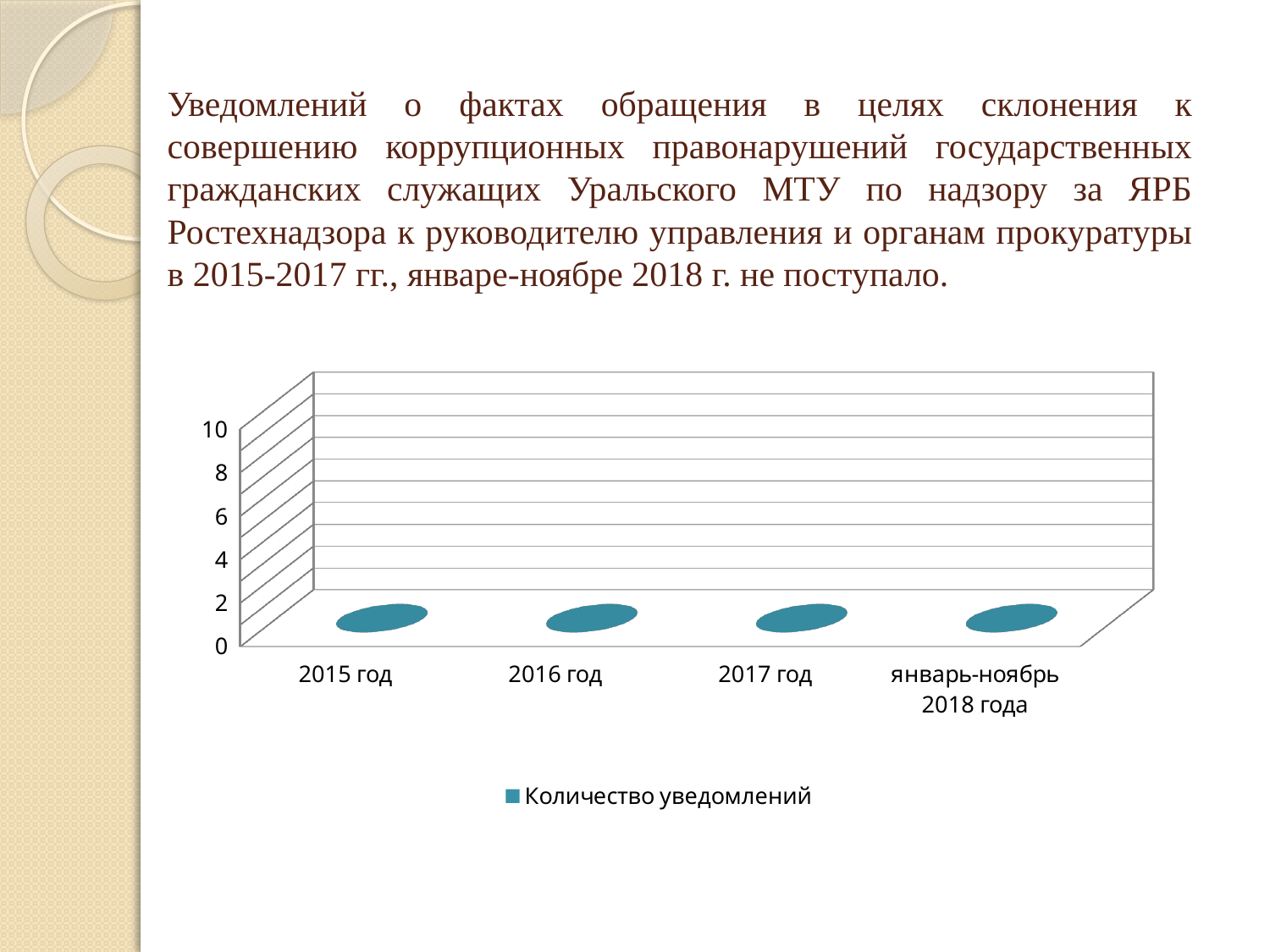
Is the value for 2017 год greater or less than 2? less What is the name of the series in the chart's legend? Количество уведомлений What is the value for январь-ноябрь 2018 года in the chart? 0 What kind of chart is shown on the slide? bar chart Do the values rise, fall, or stay the same from 2015 год to январь-ноябрь 2018 года? stay the same What is the highest value shown on the chart's vertical axis? 10 Is the value for январь-ноябрь 2018 года greater or less than 4? less What is the value for 2016 год in the chart? 0 How many categories are shown on the x axis of the chart? 4 What is the value for 2015 год in the chart? 0 How many series does the chart's legend list? 1 What is the value for 2017 год in the chart? 0